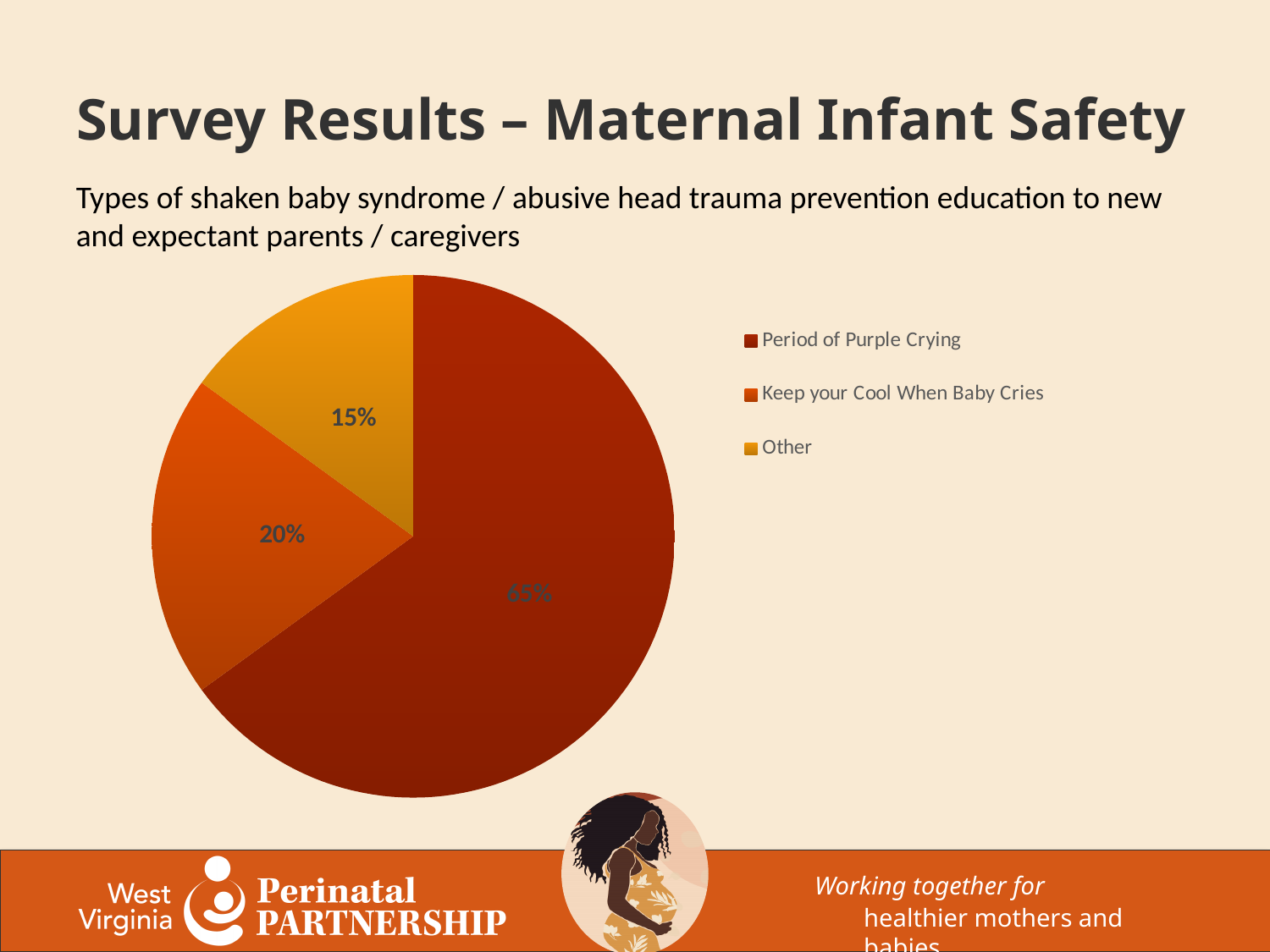
What kind of chart is shown on the slide? Pie chart Which category has the largest slice of the pie? Period of Purple Crying What is the difference in percentage points between Keep your Cool When Baby Cries and Other? 5 What is the combined share of Keep your Cool When Baby Cries and Other? 35% How many categories are shown in the pie chart? 3 What share of the pie does Period of Purple Crying represent? 65% What share of the pie does Keep your Cool When Baby Cries represent? 20% How many entries does the legend list? 3 What share of the pie does Other represent? 15% What is the difference in percentage points between Period of Purple Crying and Keep your Cool When Baby Cries? 45 Which is larger: the slice for Keep your Cool When Baby Cries or the slice for Other? Keep your Cool When Baby Cries Which category has the smallest slice of the pie? Other